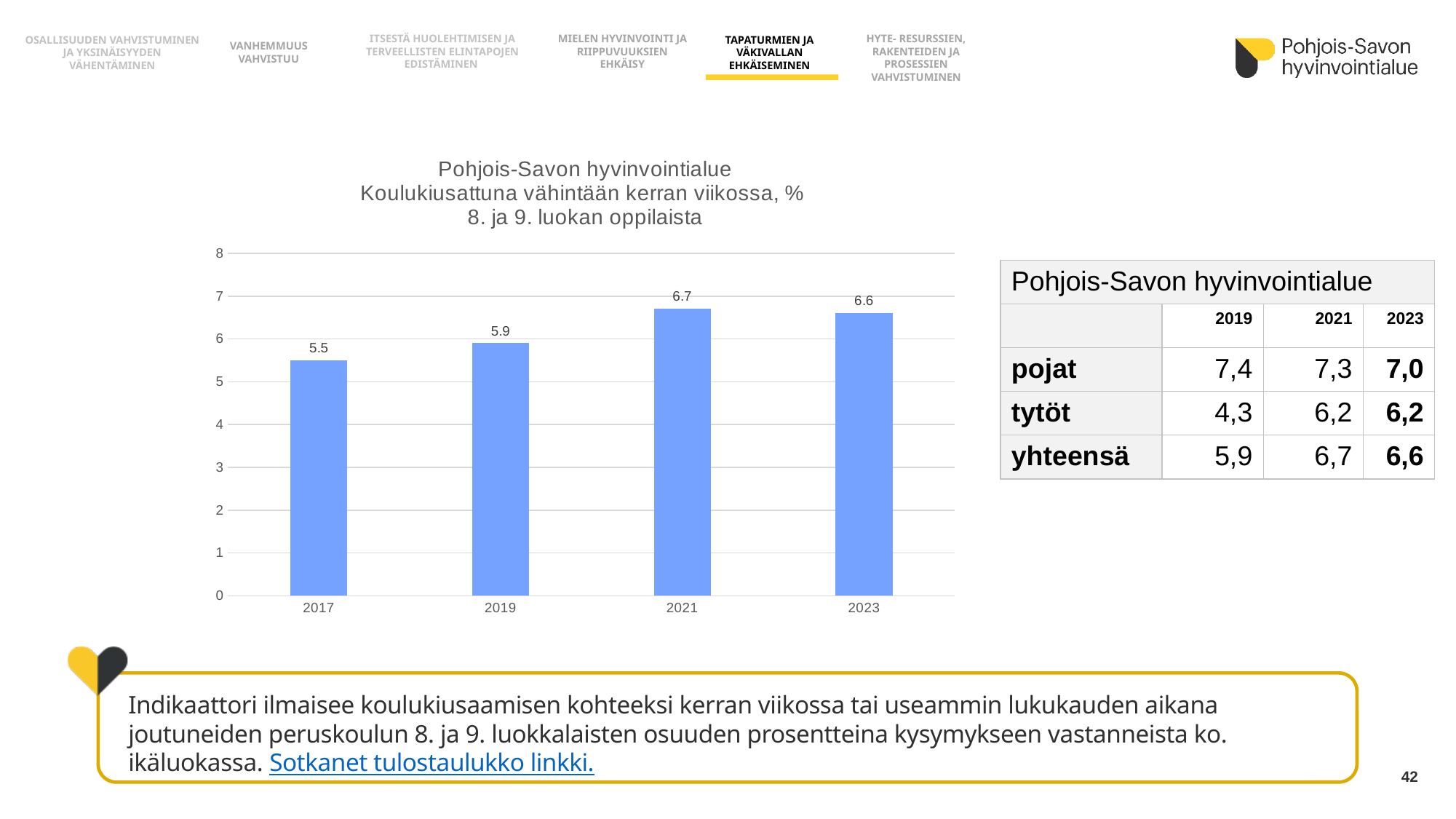
What is the title of the bar chart? Pohjois-Savon hyvinvointialue Koulukiusattuna vähintään kerran viikossa, % 8. ja 9. luokan oppilaista Is the value for 2019 in the bar chart greater or less than 5? greater Which year has the highest value in the bar chart? 2021 What is the value for 2017 in the bar chart? 5.5 What is the value for 2021 in the bar chart? 6.7 Which year has the lowest value in the bar chart? 2017 What is the difference between the values for 2021 and 2017 in the bar chart? 1.2 Does the value in the bar chart rise or fall from 2017 to 2021? rise Which is larger in the bar chart, the value for 2019 or the value for 2023? 2023 What kind of chart is shown on the slide? bar chart How many years are shown on the x axis of the bar chart? 4 What is the value for 2023 in the bar chart? 6.6